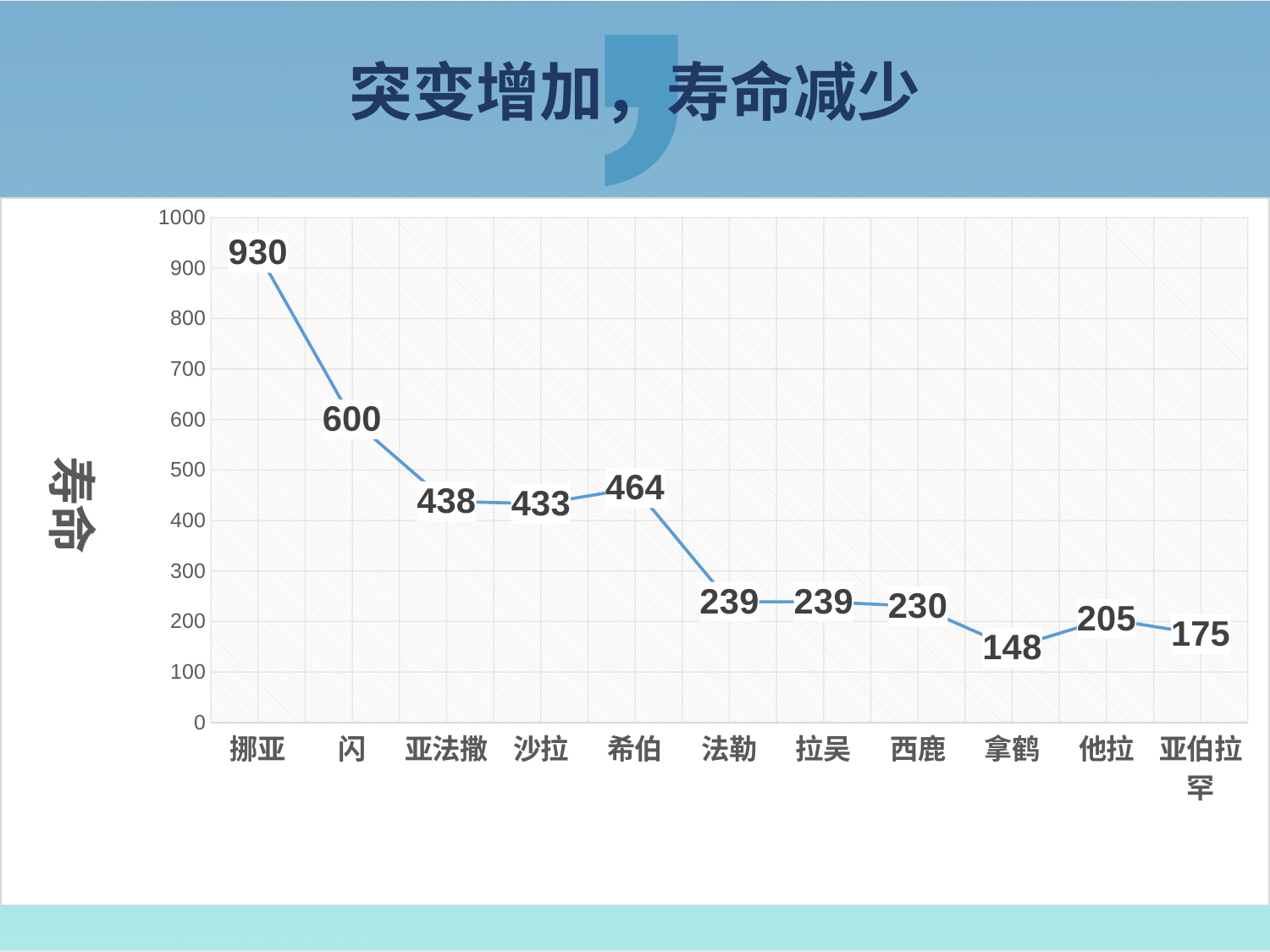
What is the difference between the values for 挪亚 and 闪? 330 What is the value for 拿鹤? 148 What is the value for 挪亚? 930 Which category has the highest value? 挪亚 Which category has the lowest value? 拿鹤 What is the value for 希伯? 464 What kind of chart is shown on the slide? line chart What is the difference between the values for 他拉 and 亚伯拉罕? 30 How many categories are shown on the x axis? 11 Do the values generally rise or fall from left to right along the x axis? fall What is the value for 亚伯拉罕? 175 Which is larger, the value for 亚法撒 or the value for 希伯? 希伯